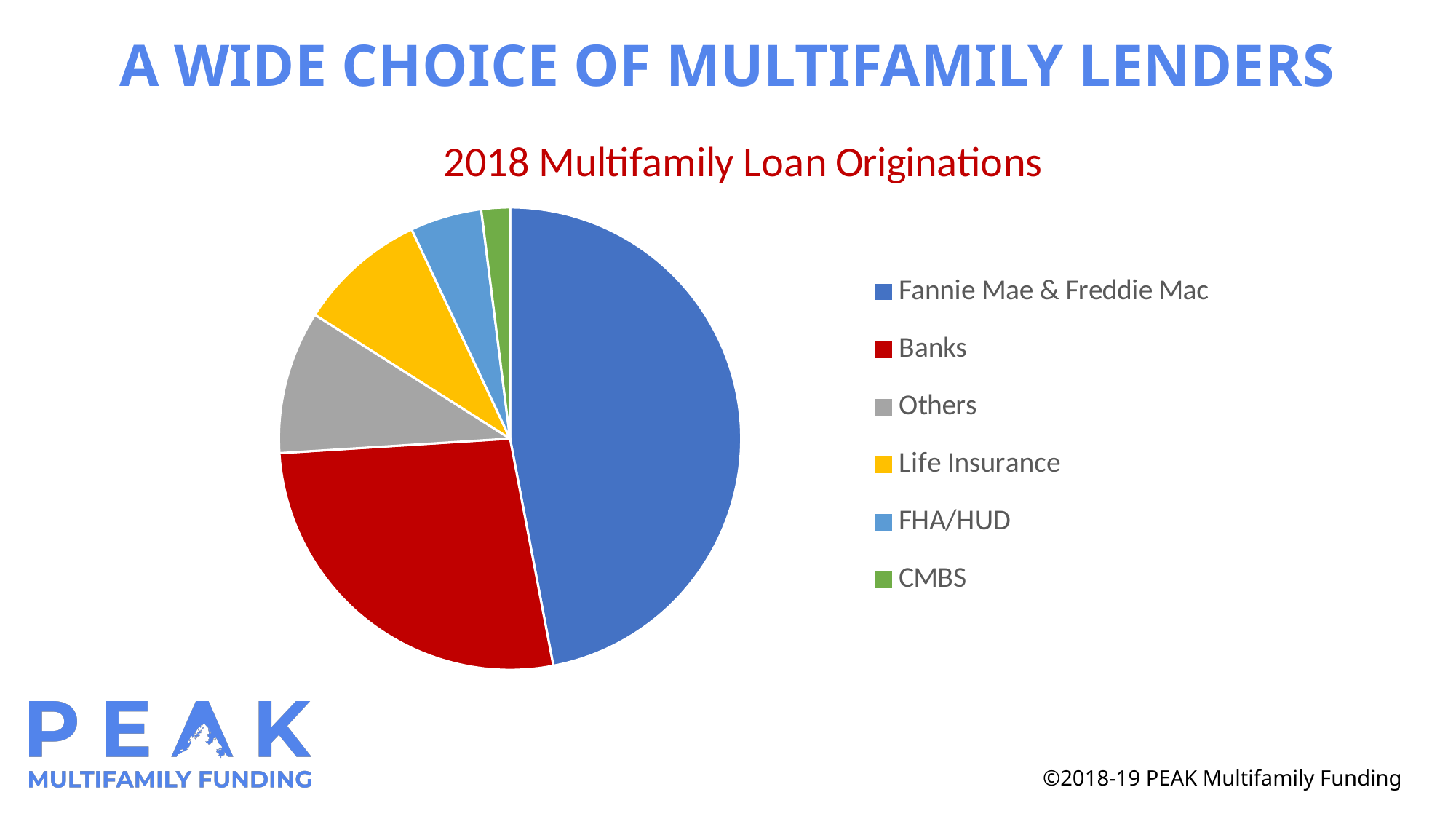
Which category has the largest slice of the pie? Fannie Mae & Freddie Mac What is the title of the chart? 2018 Multifamily Loan Originations Which category has the smallest slice of the pie? CMBS Which slice is larger, Life Insurance or FHA/HUD? Life Insurance Which slice is larger, Fannie Mae & Freddie Mac or Banks? Fannie Mae & Freddie Mac What kind of chart is shown on the slide? Pie chart How many categories (slices) does the pie chart have? 6 Which slice is larger, FHA/HUD or CMBS? FHA/HUD Which category is shown in yellow in the pie chart? Life Insurance How many entries does the legend list? 6